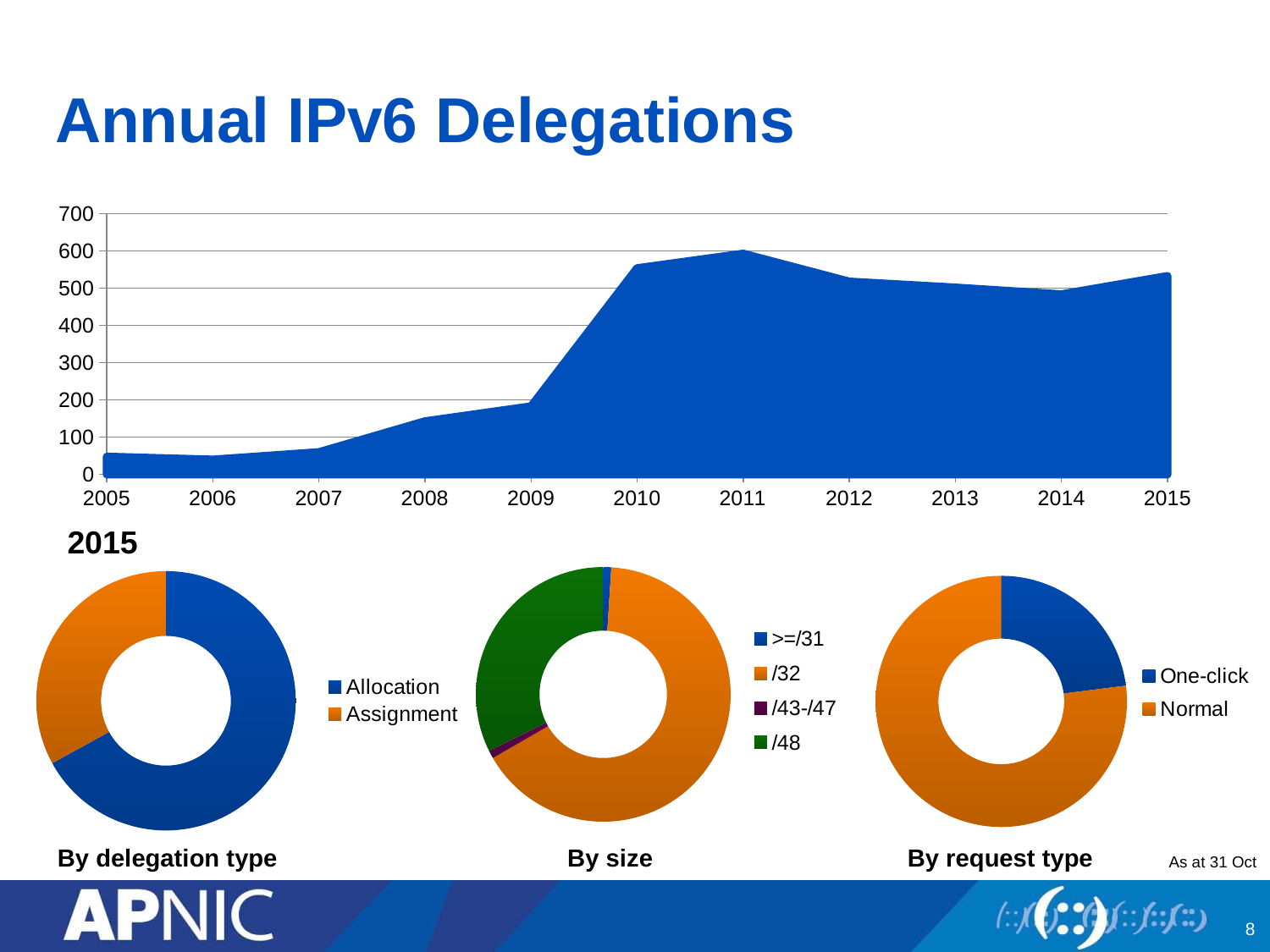
In the top area chart, is the value for 2010 greater or less than 500? greater In the top area chart, how many years are shown on the x axis? 11 How many categories does the legend of the 'By size' donut chart list? 4 In the top area chart, is the value for 2009 greater or less than 200? less In the 'By delegation type' donut chart, which category has the larger share, Allocation or Assignment? Allocation In the 'By request type' donut chart, which category has the larger share, One-click or Normal? Normal In the top area chart, which is larger, the value for 2011 or the value for 2014? 2011 What kind of chart is the top chart on the slide, showing annual IPv6 delegations from 2005 to 2015? Area chart In the top area chart, is the value for 2008 greater or less than 100? greater In the 'By size' donut chart, which category has the largest share? /32 In the top area chart, do the values rise or fall between 2009 and 2010? Rise In the top area chart, which year has the highest number of IPv6 delegations? 2011